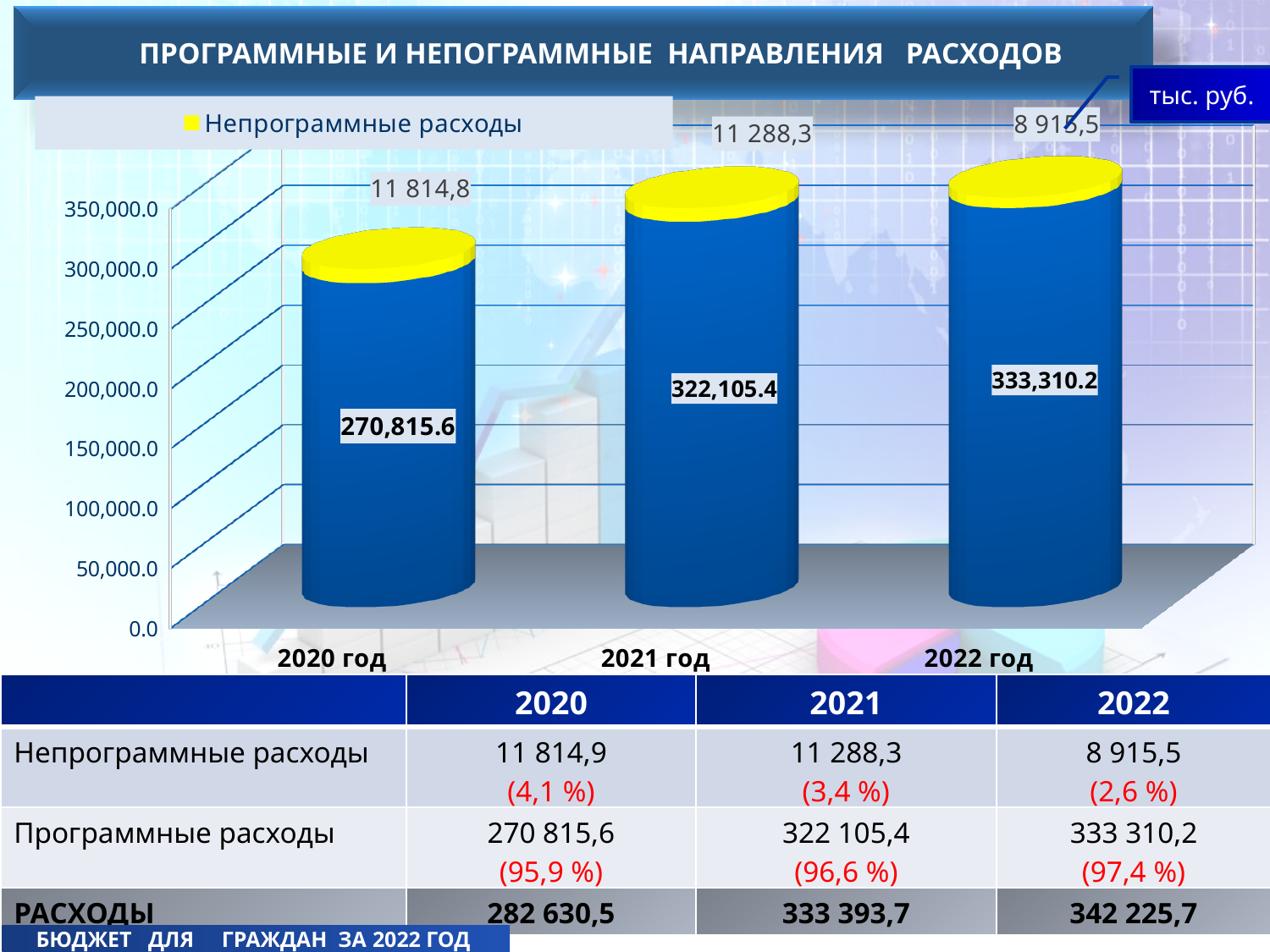
Which is larger, the blue segment for 2020 год or for 2021 год? 2021 год What is the value of the yellow segment (Непрограммные расходы) for 2020 год? 11 814,8 What is the difference between the blue segment values for 2022 год and 2021 год? 11,204.8 What is the value of the blue segment for 2020 год? 270,815.6 Do the blue segment values rise or fall from 2020 год to 2022 год? Rise How many years are shown on the x axis of the chart? 3 What kind of chart is shown on the slide? Bar chart Which year has the lowest value for Непрограммные расходы? 2022 год What is the value of the yellow segment (Непрограммные расходы) for 2022 год? 8 915,5 What is the value of the blue segment (programme expenses) for 2021 год? 322,105.4 Which year has the highest value for the blue segment (programme expenses)? 2022 год